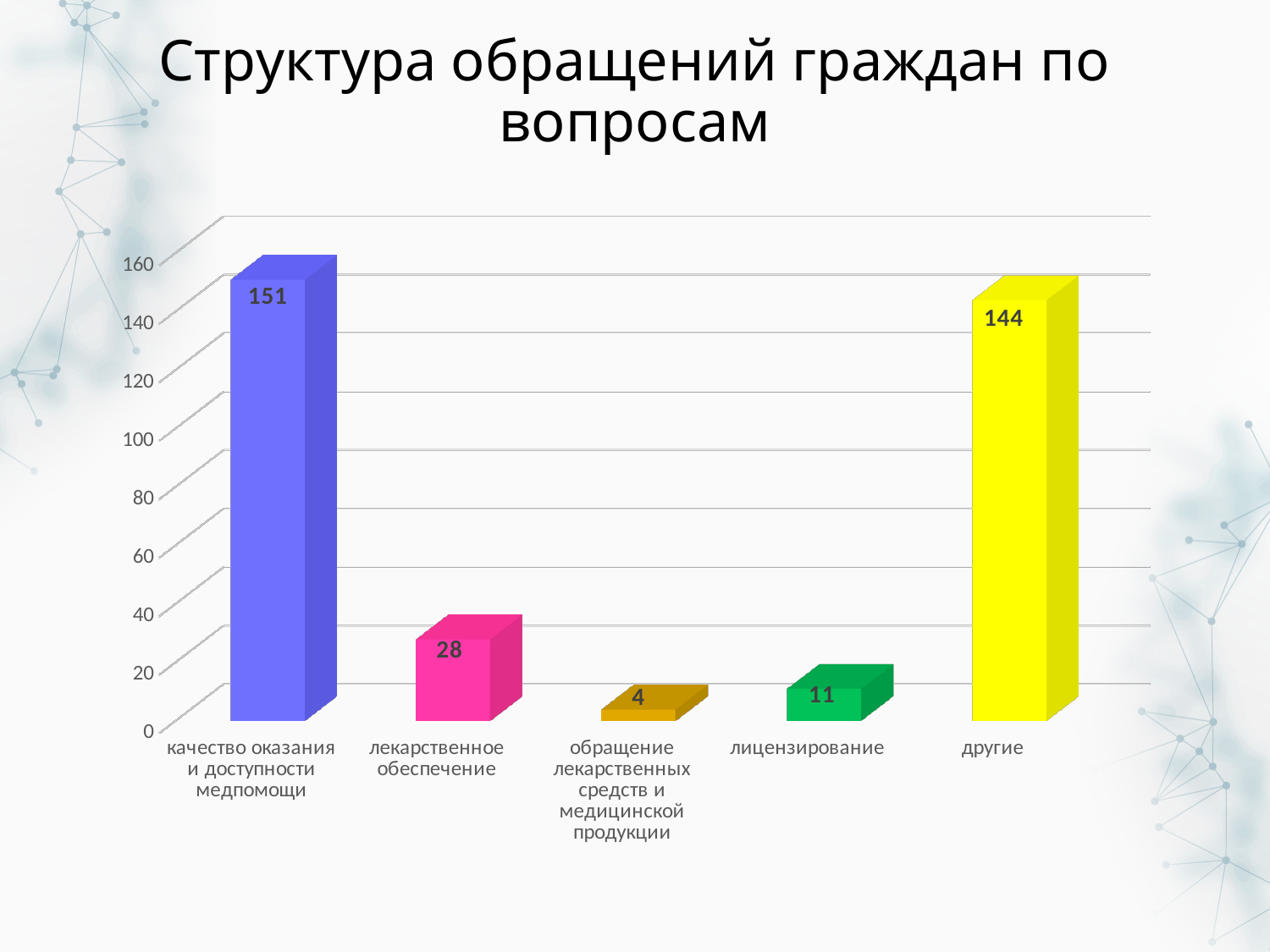
What kind of chart is shown on the slide? bar chart Which is larger, the value for "лекарственное обеспечение" or the value for "лицензирование"? лекарственное обеспечение What is the value for "другие"? 144 What is the difference between the values for "качество оказания и доступности медпомощи" and "другие"? 7 Which category has the lowest value? обращение лекарственных средств и медицинской продукции What is the title of the slide? Структура обращений граждан по вопросам How many categories are shown in the chart? 5 What is the value for "лицензирование"? 11 Which category has the highest value? качество оказания и доступности медпомощи What is the value for "лекарственное обеспечение"? 28 What is the value for "качество оказания и доступности медпомощи"? 151 What is the difference between the values for "лекарственное обеспечение" and "лицензирование"? 17